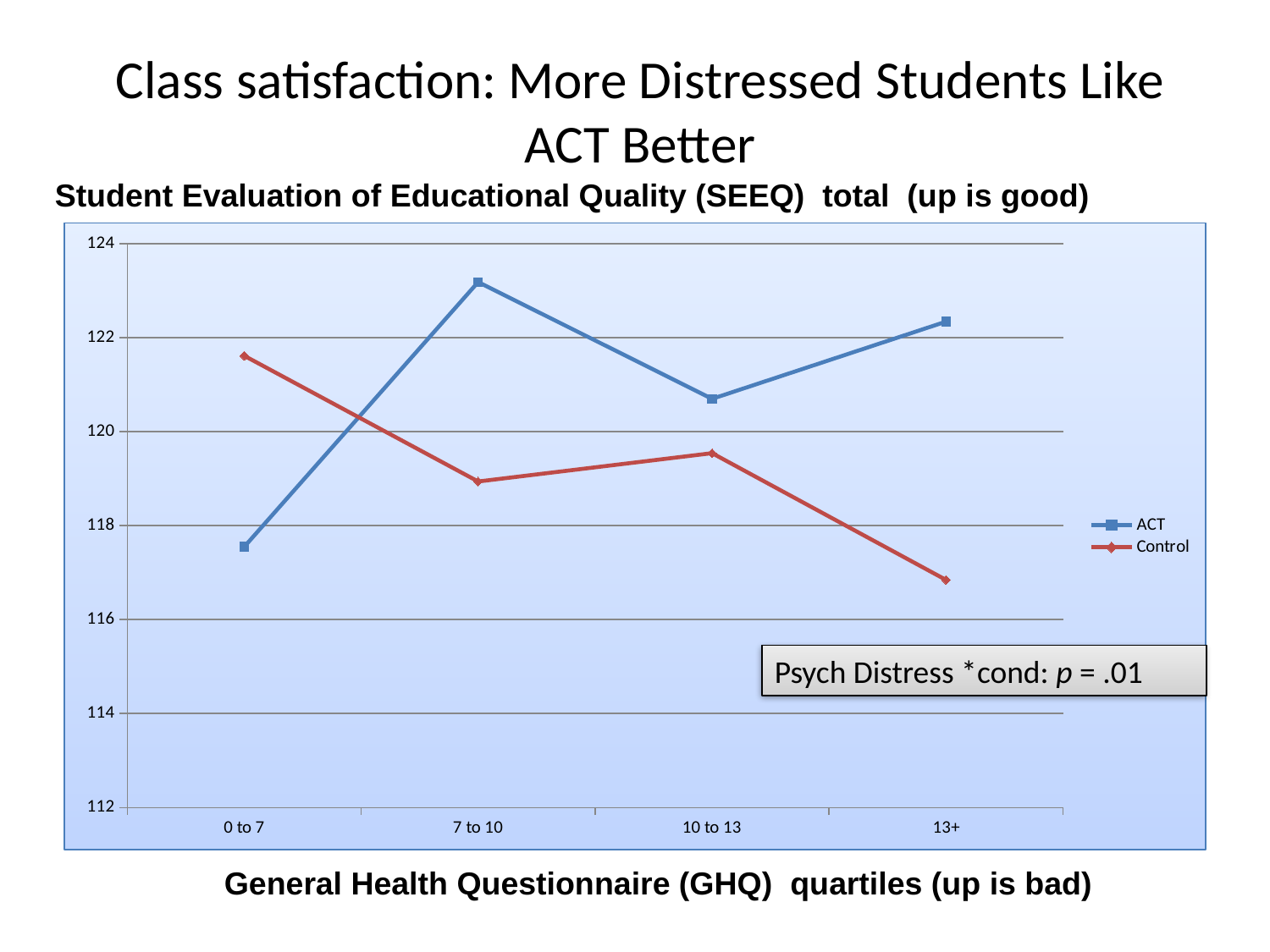
For which GHQ quartile is the ACT series highest? 7 to 10 Is the Control value for the 0 to 7 quartile greater or less than 120? greater Which series is plotted in blue? ACT What kind of chart is shown on the slide? line chart At the 0 to 7 quartile, which series has the higher value, ACT or Control? Control How many series does the legend list? 2 Is the ACT value for the 7 to 10 quartile greater or less than 122? greater At the 13+ quartile, which series has the higher value, ACT or Control? ACT Is the ACT value for the 0 to 7 quartile greater or less than 118? less How many GHQ quartile categories are shown on the x axis? 4 For which GHQ quartile is the Control series lowest? 13+